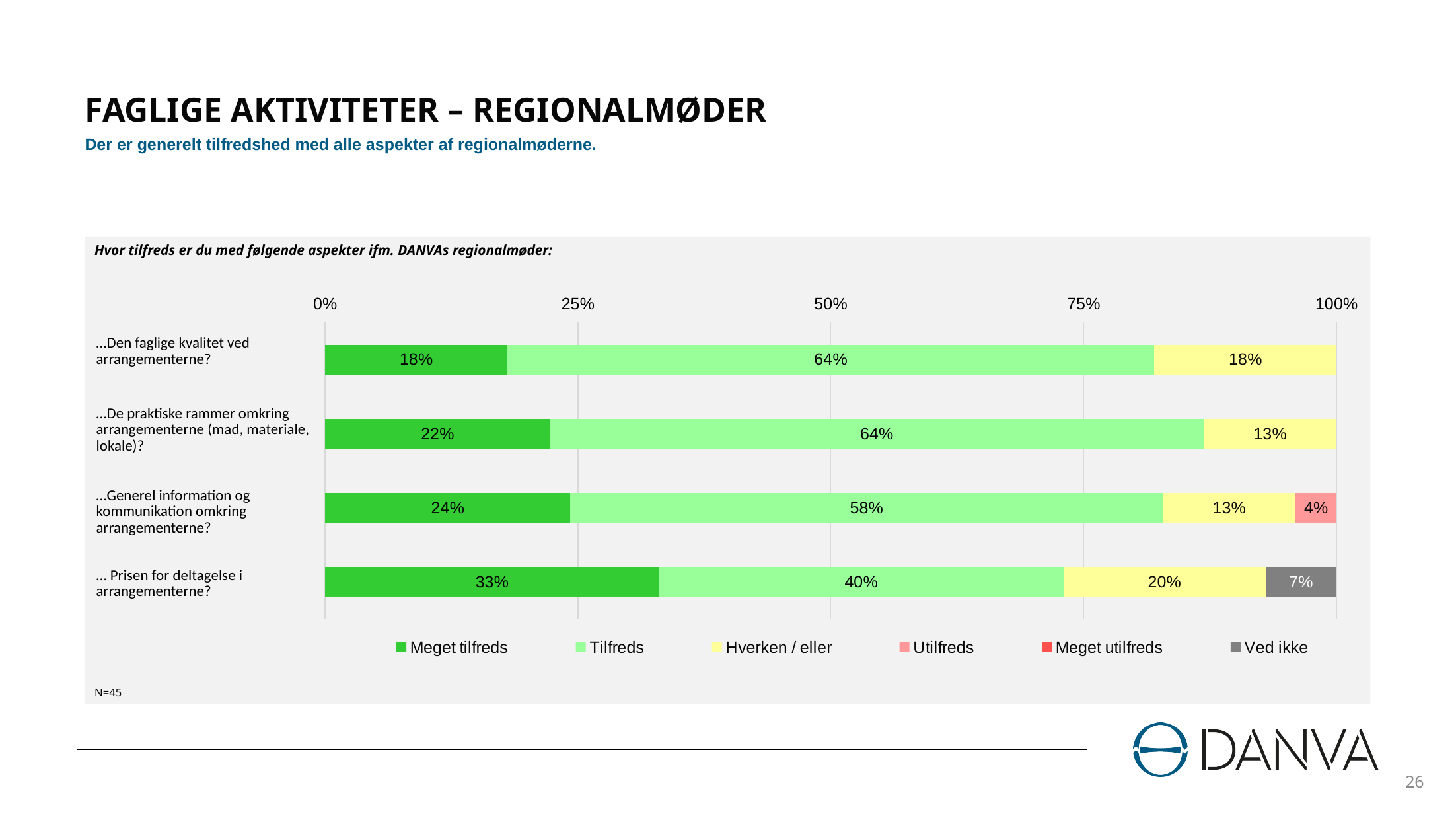
What is the "Hverken / eller" value for "De praktiske rammer omkring arrangementerne (mad, materiale, lokale)?" 13% How many aspects (categories) are shown in the chart? 4 What kind of chart is shown on the slide? Stacked bar chart What percentage answered "Meget tilfreds" for "Prisen for deltagelse i arrangementerne?" 33% How many series does the legend list? 6 How many percentage points higher is the "Meget tilfreds" share for "Prisen for deltagelse i arrangementerne?" than for "Den faglige kvalitet ved arrangementerne?" 15 percentage points What is the "Utilfreds" share for "Generel information og kommunikation omkring arrangementerne?" 4% What is the "Tilfreds" share for "Generel information og kommunikation omkring arrangementerne?" 58% Which aspect has the highest "Meget tilfreds" share? Prisen for deltagelse i arrangementerne? Which has the larger "Hverken / eller" share: "Den faglige kvalitet ved arrangementerne?" or "Prisen for deltagelse i arrangementerne?" Prisen for deltagelse i arrangementerne? Which aspect has the lowest "Tilfreds" share? Prisen for deltagelse i arrangementerne? What percentage answered "Ved ikke" for "Prisen for deltagelse i arrangementerne?" 7%